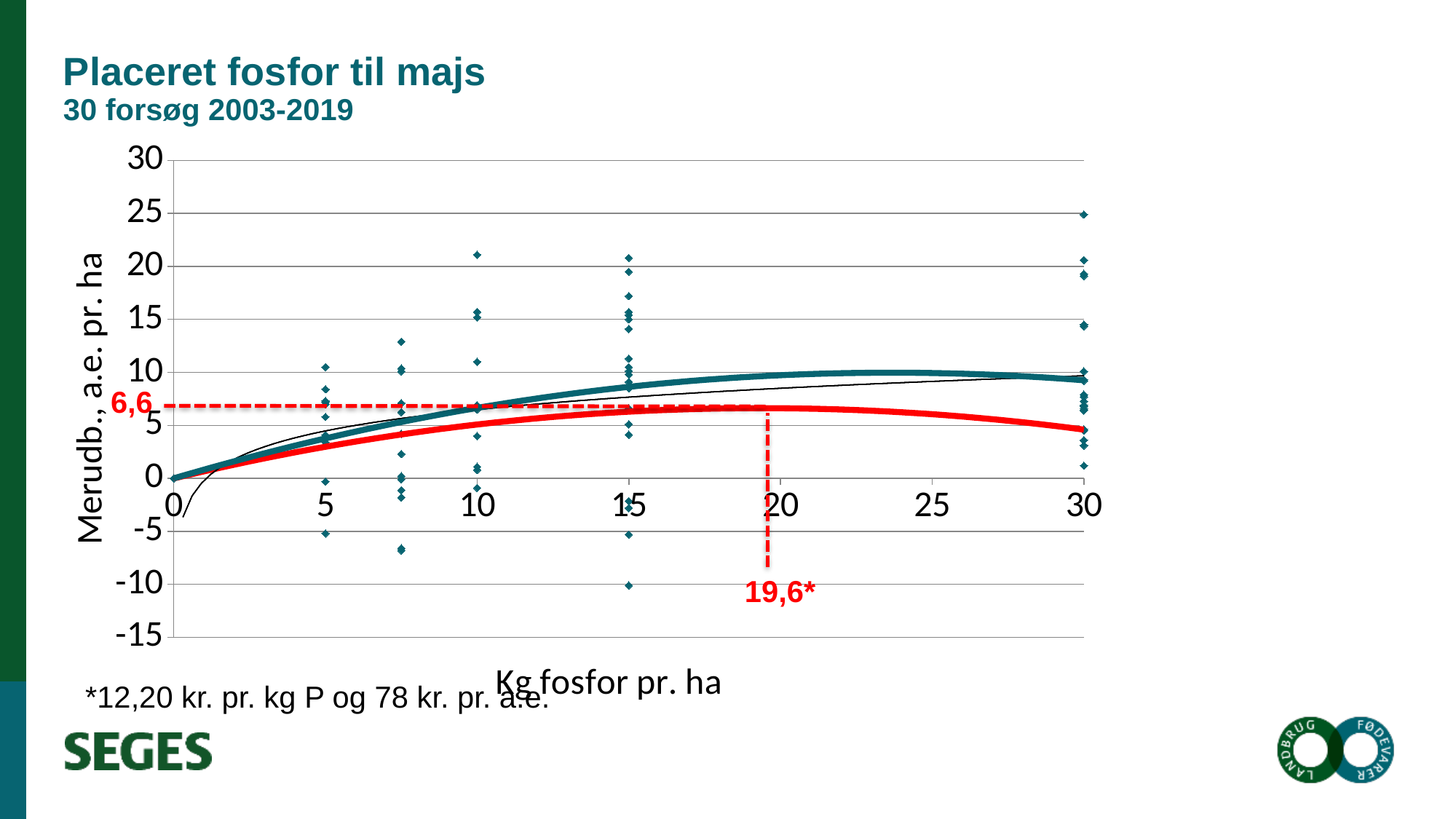
Is the value of the red curve at 30 kg fosfor pr. ha greater or less than 10? less What x-axis value is marked by the red dashed vertical line? 19,6* What is the label of the y axis? Merudb., a.e. pr. ha What is the title of the chart on the slide? Placeret fosfor til majs What is the highest value shown on the x axis? 30 Is the lowest scatter point at 15 kg fosfor pr. ha greater or less than -5? less What kind of chart is shown on the slide? Scatter chart with fitted curves Is the value of the teal curve at 30 kg fosfor pr. ha greater or less than 5? greater At 30 kg fosfor pr. ha, which curve is higher, the teal curve or the red curve? The teal curve What value is marked by the red dashed horizontal line? 6,6 What is the lowest value shown on the y axis? -15